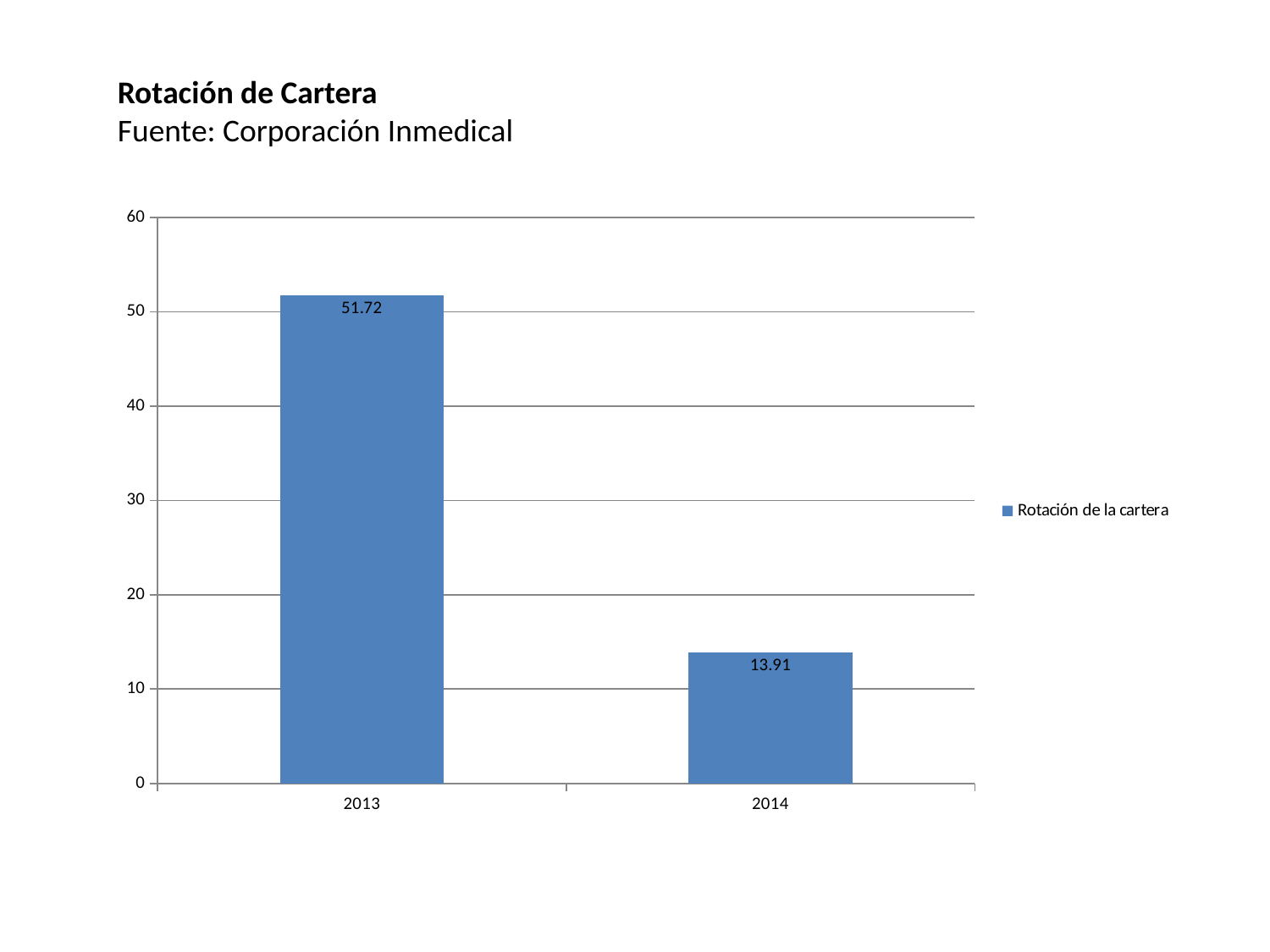
Which is larger, the value for 2013 or the value for 2014? 2013 What kind of chart is shown on the slide? bar chart Which year has the lowest Rotación de la cartera? 2014 Is the value for 2013 greater or less than 50? greater How many years are shown on the x axis? 2 Does the value rise or fall from 2013 to 2014? fall How many series does the legend list? 1 What is the value of Rotación de la cartera for 2014? 13.91 What is the difference between the 2013 and 2014 values of Rotación de la cartera? 37.81 Which year has the highest Rotación de la cartera? 2013 What is the value of Rotación de la cartera for 2013? 51.72 Is the value for 2014 greater or less than 20? less